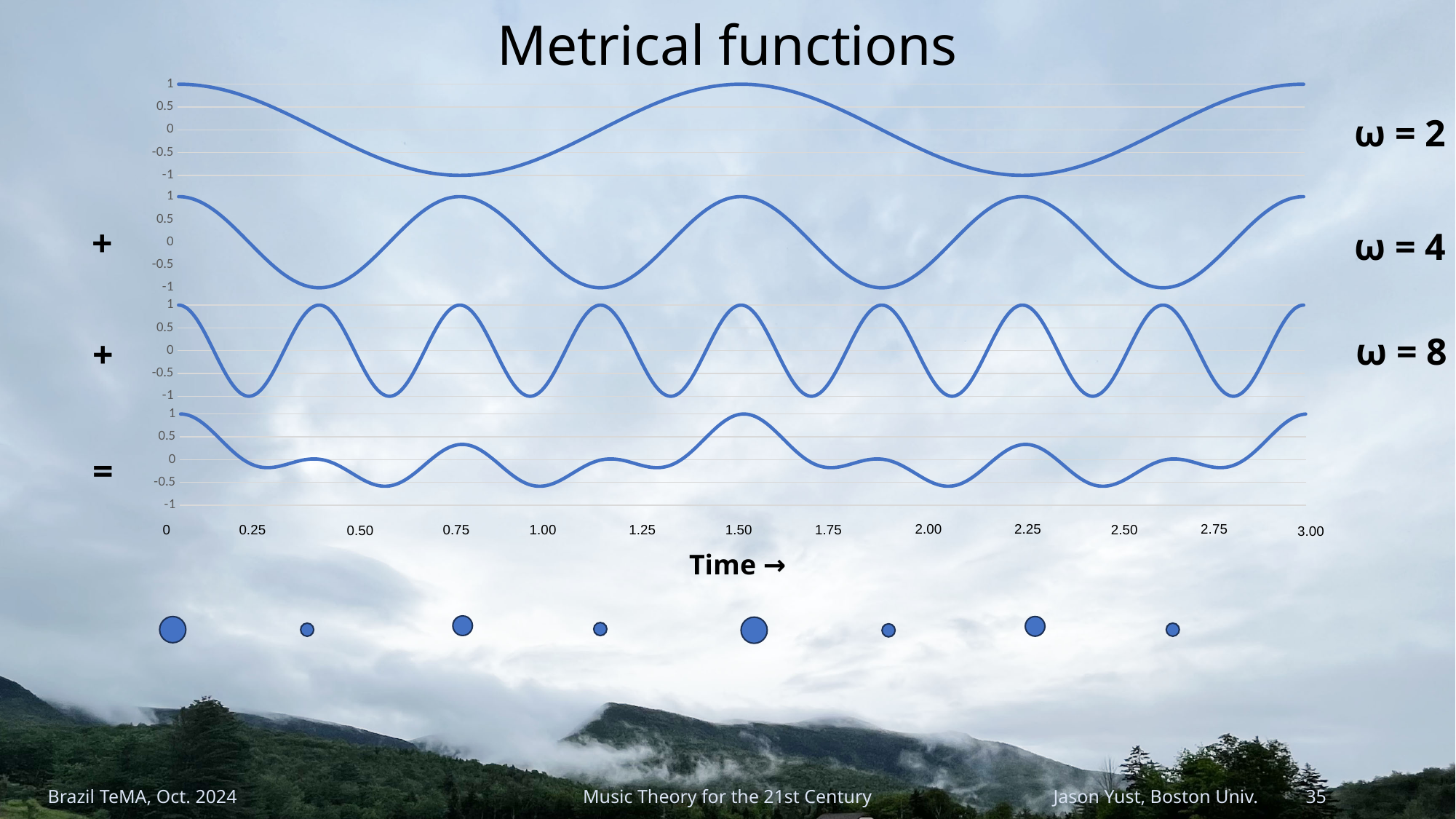
In the bottom chart (the sum, marked =), is the value at time 1.50 greater or less than 0.5? greater What is the highest value shown on the x axis of the charts? 3.00 In the bottom chart (the sum, marked =), is the value at time 0.75 greater or less than 0? greater In the ω = 2 chart, what is the value of the curve at time 0.75? -1 In the ω = 4 chart, what is the value of the curve at time 0.75? 1 What is the label on the x axis of the charts? Time → How many peaks reaching 1 does the ω = 8 curve have between time 0 and 3.00 inclusive? 9 What kind of chart is used for the ω = 2 plot at the top of the slide? line chart In the ω = 2 chart, what is the value of the curve at time 0? 1 In the ω = 2 chart, what is the value of the curve at time 1.50? 1 In the ω = 2 chart, does the curve rise or fall between time 0 and time 0.75? fall How many separate line charts are stacked on the slide? 4